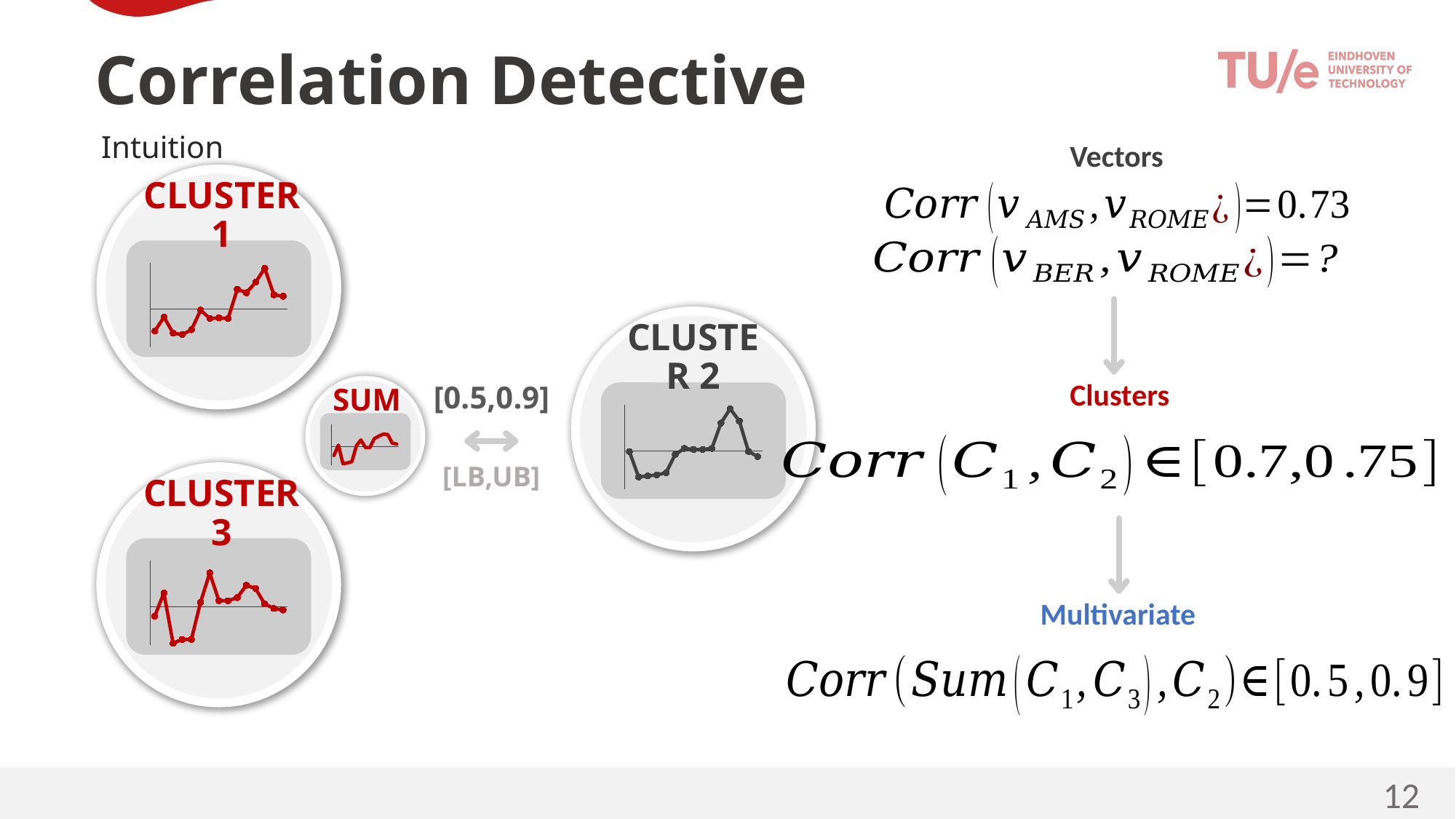
In the CLUSTER 1 chart, do the values generally rise or fall along the x axis? rise How many small line charts are shown on the slide? 4 What kind of chart is shown inside the CLUSTER 1 circle? line chart What kind of chart is shown inside the CLUSTER 2 circle? line chart What colour is the line in the CLUSTER 1 chart? red What colour is the line in the CLUSTER 2 chart? grey